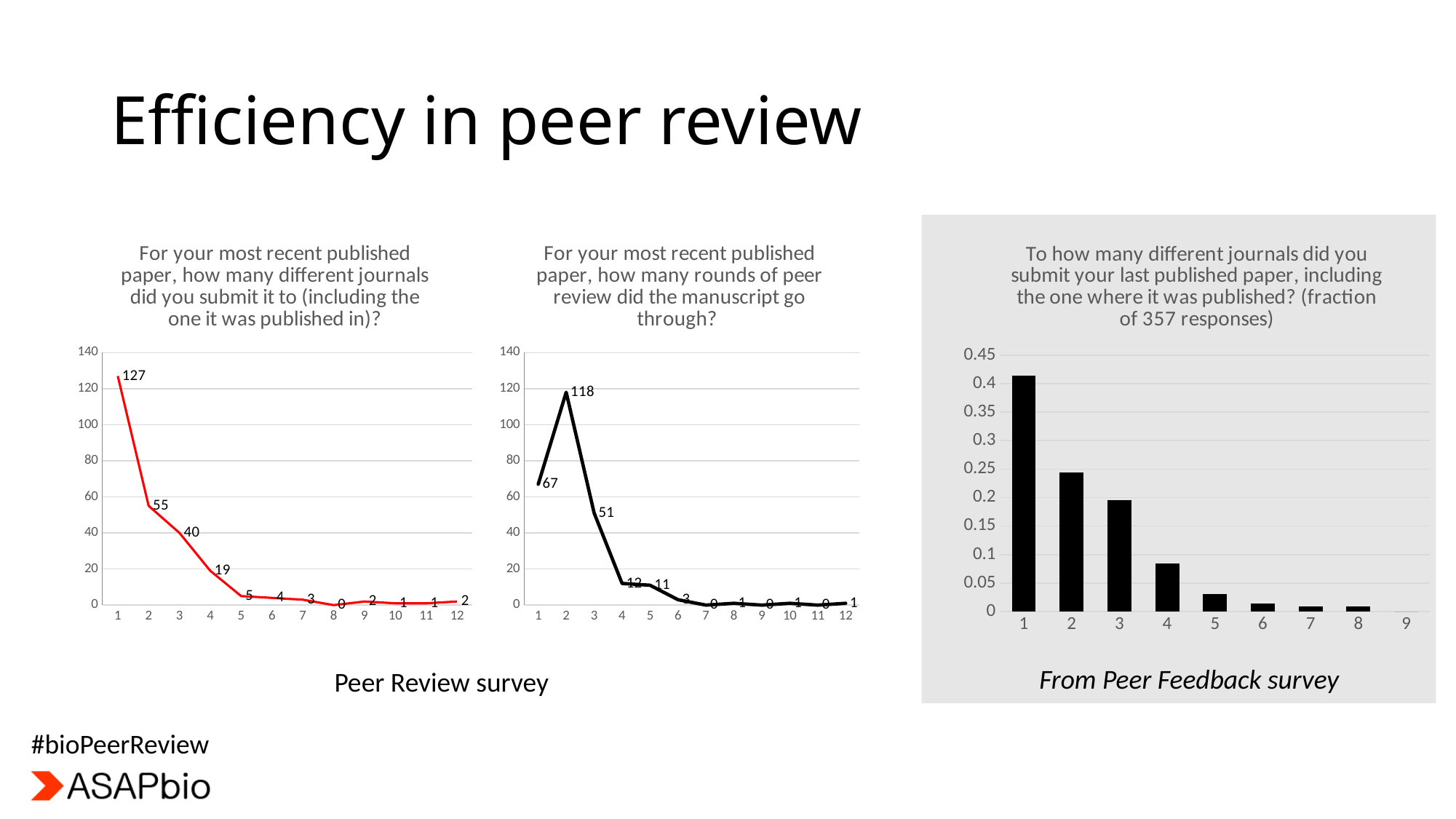
In the left chart, is the value at x = 2 larger or smaller than the value at x = 3 in the middle chart? larger In the left chart (how many different journals did you submit it to), what is the difference between the values at x = 1 and x = 2? 72 In the middle chart (how many rounds of peer review), which x value has the highest count? 2 In the right-hand chart (fraction of 357 responses), is the value for category 1 greater or less than 0.4? greater What kind of chart is the right-hand chart (fraction of 357 responses)? bar chart In the middle chart (how many rounds of peer review), what is the difference between the values at x = 2 and x = 3? 67 What kind of chart is the left chart (how many different journals did you submit it to)? line chart In the middle chart (how many rounds of peer review), what is the value at x = 1? 67 In the left chart (how many different journals did you submit it to), what is the value at x = 4? 19 In the left chart (how many different journals did you submit it to), what is the value at x = 1? 127 In the right-hand chart (fraction of 357 responses), which category has the highest bar? 1